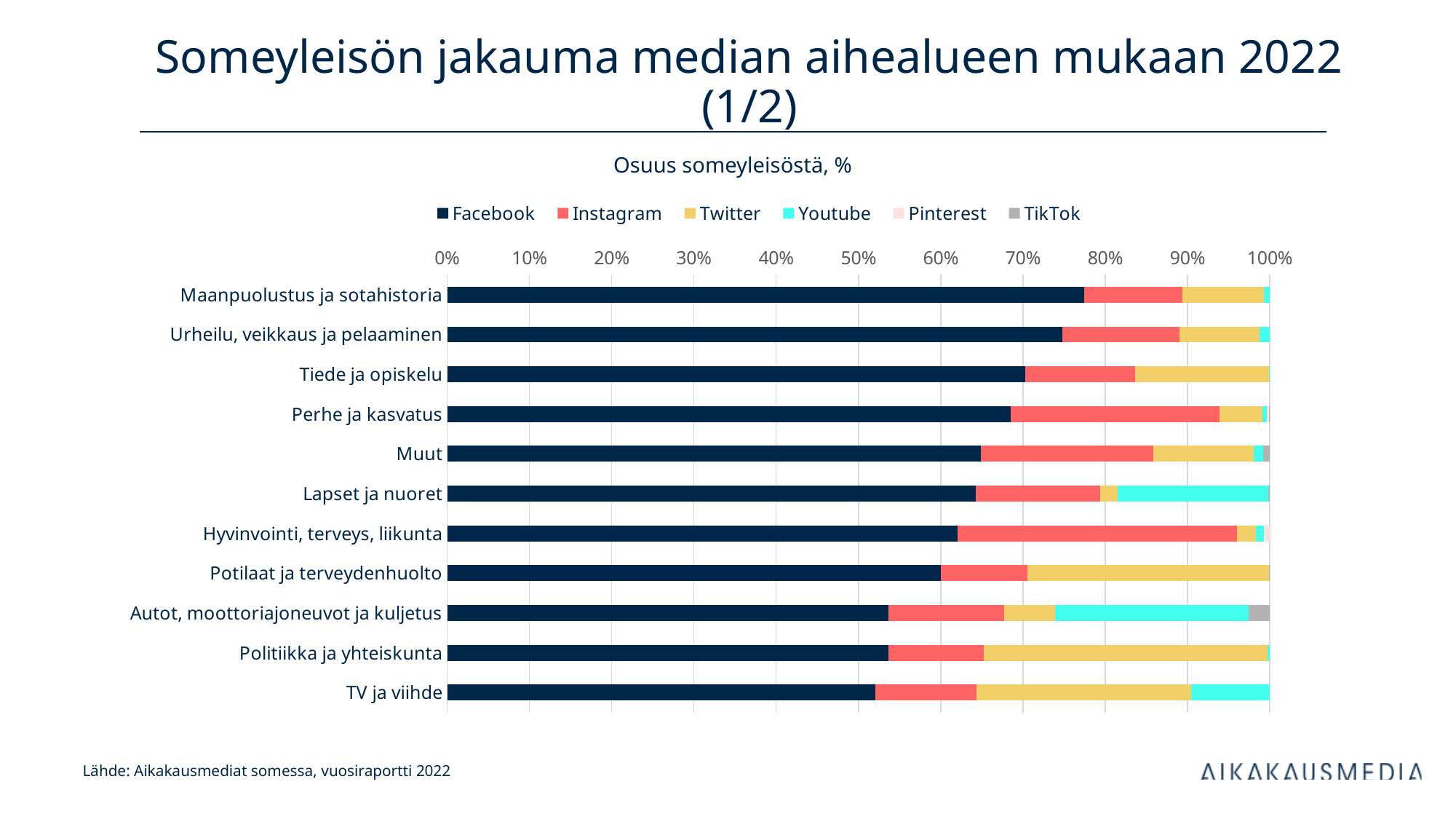
Which category has the largest Twitter share? Politiikka ja yhteiskunta What is the title of the chart's value axis? Osuus someyleisöstä, % How many series does the legend list? 6 Which has the larger Instagram share: Hyvinvointi, terveys, liikunta or Politiikka ja yhteiskunta? Hyvinvointi, terveys, liikunta Which category has the largest Facebook share? Maanpuolustus ja sotahistoria Which category has the largest Youtube share? Autot, moottoriajoneuvot ja kuljetus What kind of chart is shown on the slide? Stacked bar chart Is the Facebook share for TV ja viihde greater or less than 60%? less How many media topic categories are listed on the chart? 11 Is the Facebook share for Perhe ja kasvatus greater or less than 60%? greater Is the Facebook share for Maanpuolustus ja sotahistoria greater or less than 70%? greater